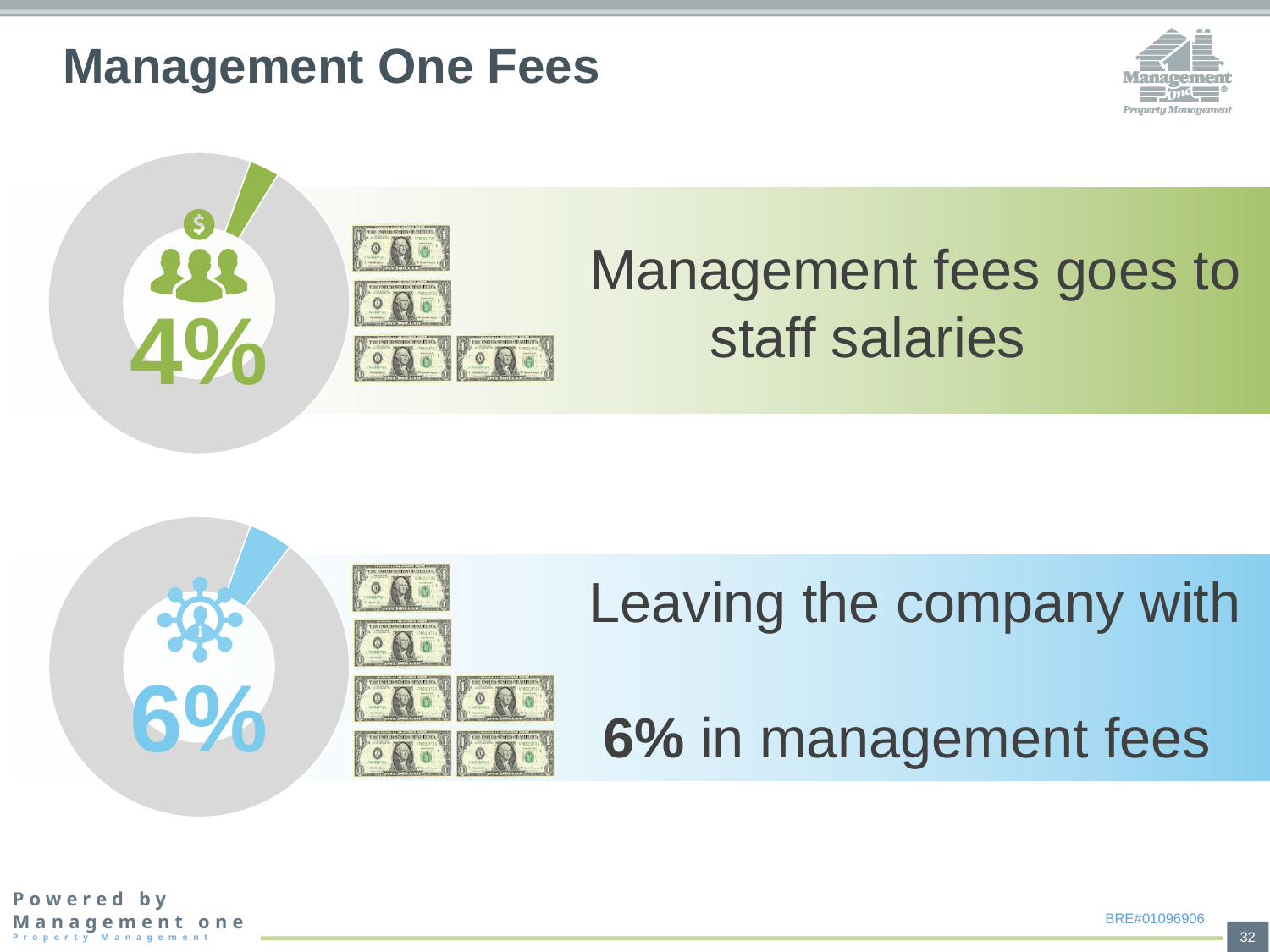
What percentage is shown in the top donut chart? 4% How many donut charts are on the slide? 2 What percentage is shown in the bottom donut chart? 6% According to the slide, what percentage in management fees is the company left with? 6% Which chart shows the larger percentage, the top one or the bottom one? The bottom one What kind of chart is used to show the 4% and 6% figures on the slide? Donut chart Is the value shown in the bottom chart greater or less than 5%? greater According to the slide, what percentage of management fees goes to staff salaries? 4% Is the value shown in the top chart greater or less than 5%? less What colour is the highlighted slice in the bottom donut chart? Blue What is the difference between the percentage in the bottom chart and the percentage in the top chart? 2% What colour is the highlighted slice in the top donut chart? Green